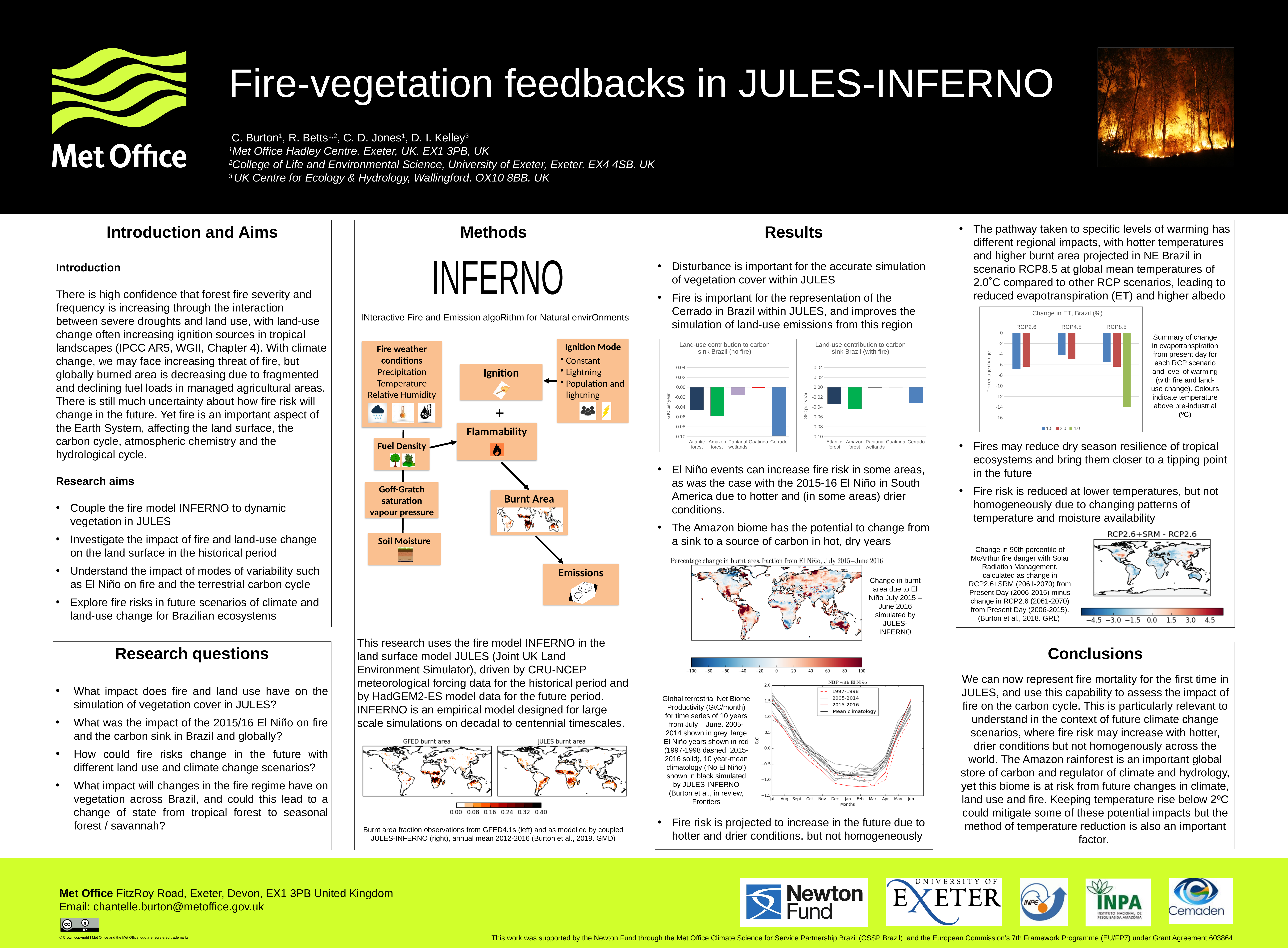
In the 'Change in ET, Brazil (%)' chart, which scenario and warming level shows the largest decrease in ET? RCP8.5 at 4.0 In the 'Land-use contribution to carbon sink Brazil (no fire)' chart, is the value for Atlantic forest greater or less than -0.06? greater In the 'Land-use contribution to carbon sink Brazil (with fire)' chart, is the value for Amazon forest greater or less than -0.02? less In the 'Change in ET, Brazil (%)' chart, what are the legend entries? 1.5, 2.0, 4.0 In the 'NBP with El Niño' chart, how many series does the legend list? 4 In the 'Change in ET, Brazil (%)' chart, how many series does the legend list? 3 In the 'Land-use contribution to carbon sink Brazil (no fire)' chart, what kind of chart is shown? bar chart In the 'Land-use contribution to carbon sink Brazil (no fire)' chart, which biome has the most negative value? Cerrado In the 'Land-use contribution to carbon sink Brazil (no fire)' chart, is the value for Cerrado greater or less than -0.08? less In the 'Land-use contribution to carbon sink Brazil (no fire)' chart, how many biome categories are plotted? 5 In the 'Land-use contribution to carbon sink Brazil (with fire)' chart, which biome has the most negative value? Amazon forest